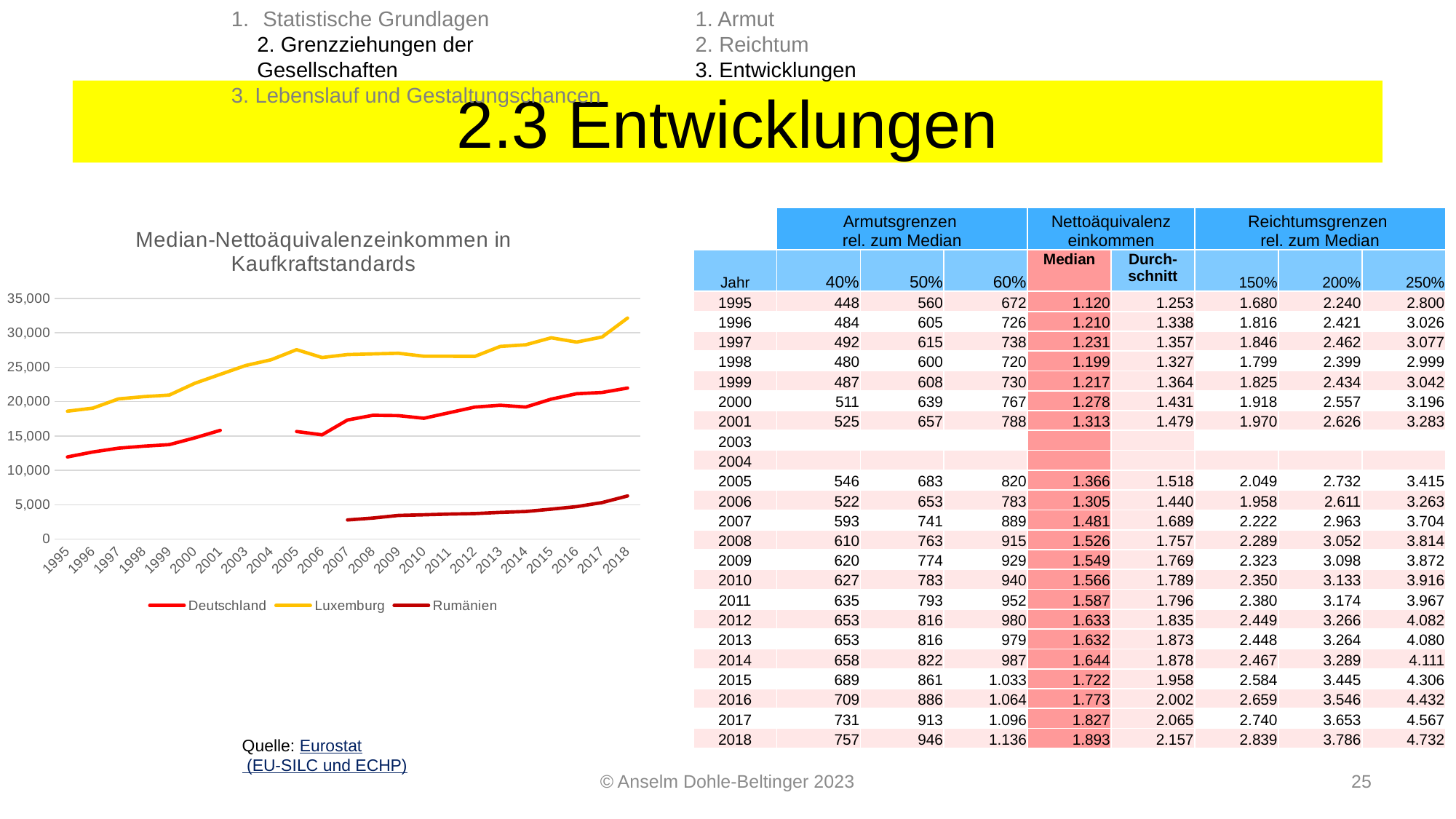
Is the value for Deutschland in 2018 greater or less than 20,000? greater Which country has the highest value in 2018 in the chart? Luxemburg Does the Luxemburg line rise or fall overall from 1995 to 2018? rises In 1995, which is larger: the value for Deutschland or the value for Luxemburg? Luxemburg What is the title of the chart? Median-Nettoäquivalenzeinkommen in Kaufkraftstandards Is the value for Luxemburg in 2018 greater or less than 30,000? greater Is the value for Deutschland in 1995 greater or less than 15,000? less What kind of chart is shown on the slide? line chart Which series in the chart is drawn in yellow? Luxemburg Which country has the lowest value in 2018 in the chart? Rumänien How many series does the chart legend list? 3